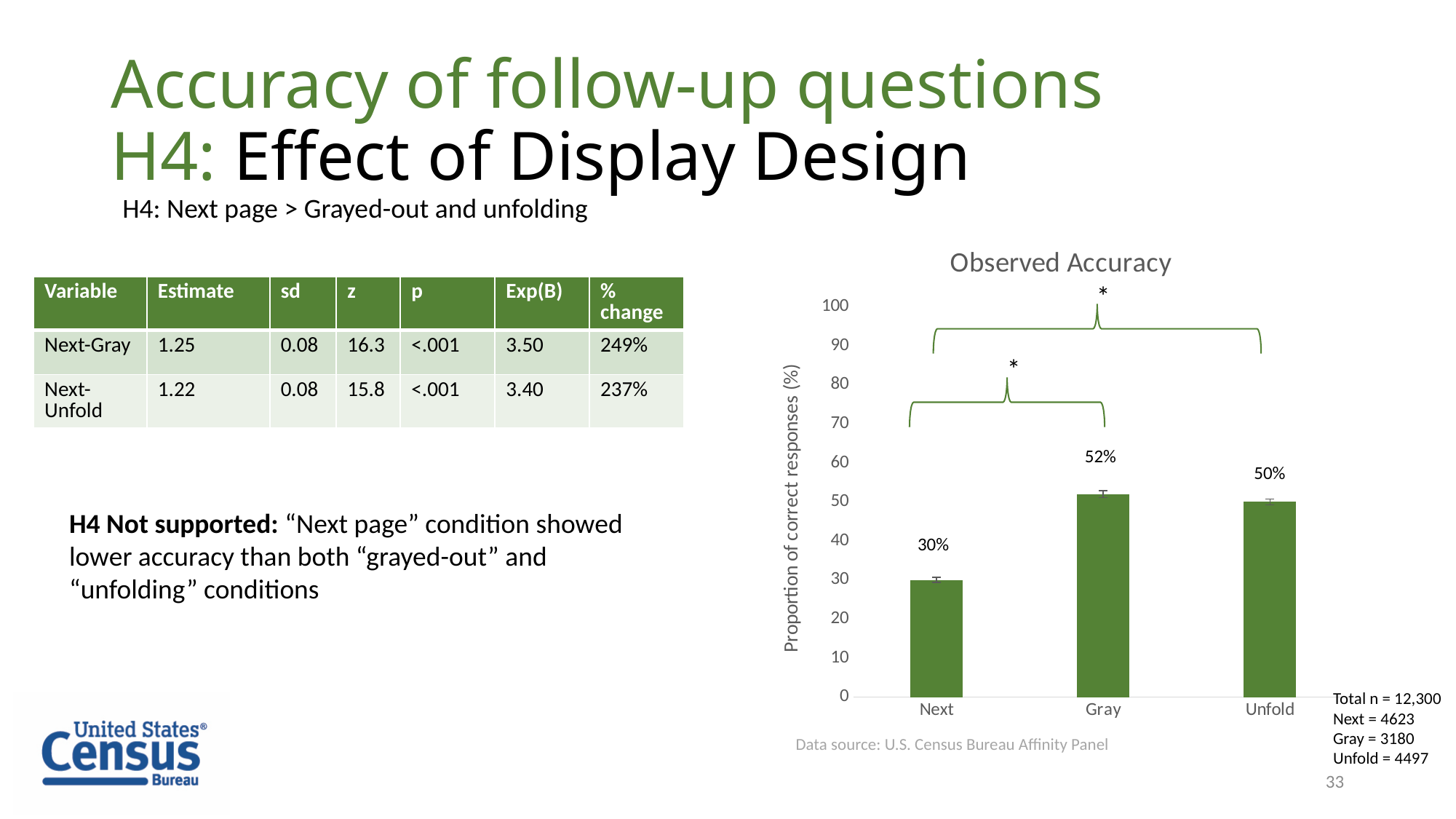
How many conditions are shown on the x axis of the chart? 3 Which condition has the highest observed accuracy? Gray What is the title of the chart? Observed Accuracy Is the value for Next greater or less than 40? less What is the observed accuracy for the Next condition? 30% What is the difference in observed accuracy between the Unfold and Next conditions? 20% What is the difference in observed accuracy between the Gray and Next conditions? 22% Which condition has the lowest observed accuracy? Next What is the observed accuracy for the Unfold condition? 50% What is the observed accuracy for the Gray condition? 52% Which has a higher observed accuracy, Next or Unfold? Unfold What kind of chart is shown on the slide? bar chart